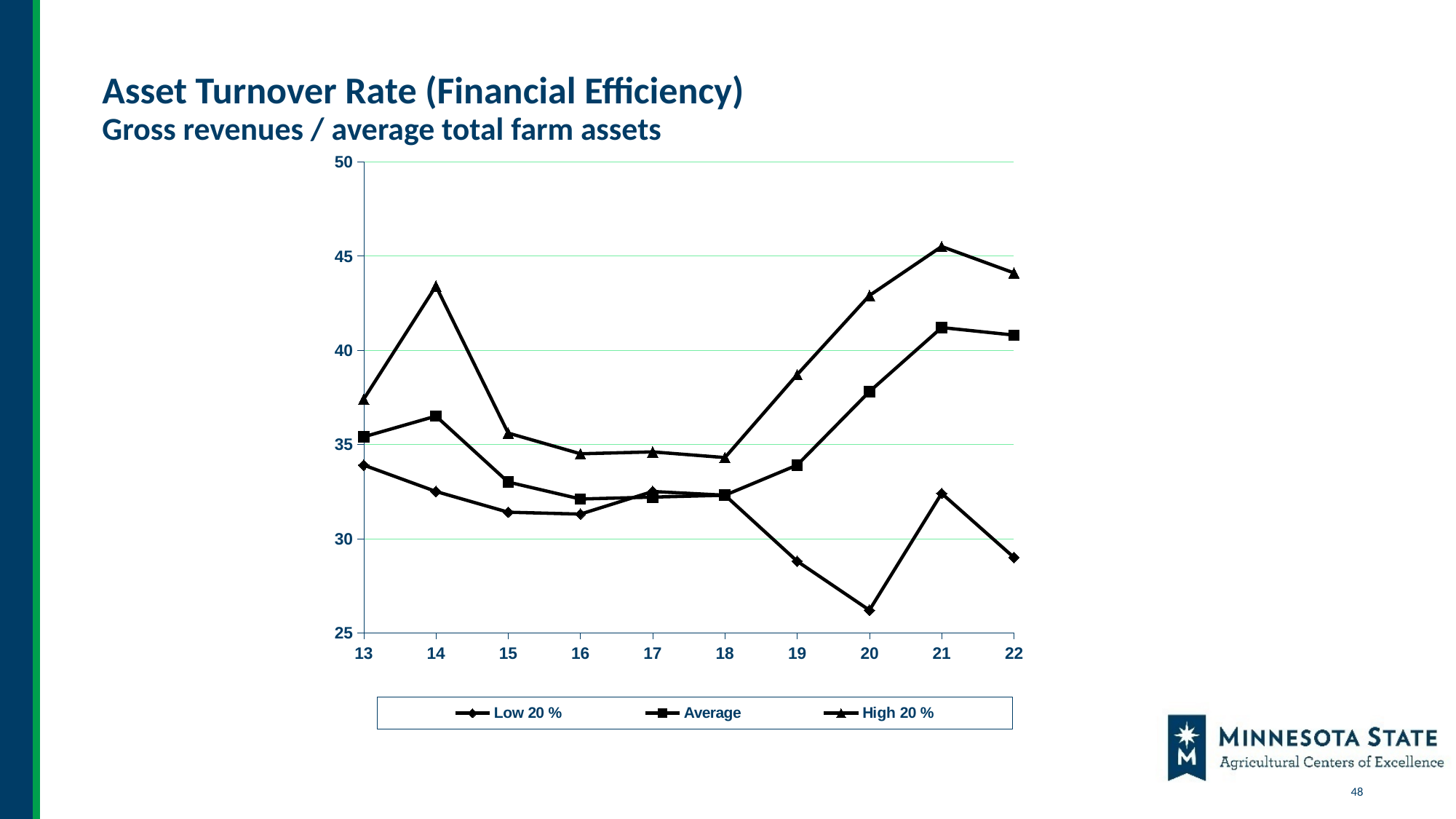
Is the value for Low 20 % in year 20 greater or less than 30? less Does the Low 20 % series rise or fall from year 17 to year 20? fall How many series does the legend list? 3 What are the three series names listed in the legend? Low 20 %, Average, High 20 % In which year does the Low 20 % series reach its lowest value? 20 In which year does the High 20 % series reach its highest value? 21 In year 22, which is larger: the Average value or the Low 20 % value? Average What kind of chart is shown on the slide? line chart Is the value for Average in year 20 greater or less than 35? greater Does the High 20 % series rise or fall from year 18 to year 21? rise Is the value for High 20 % in year 14 greater or less than 40? greater How many years are plotted along the x axis? 10